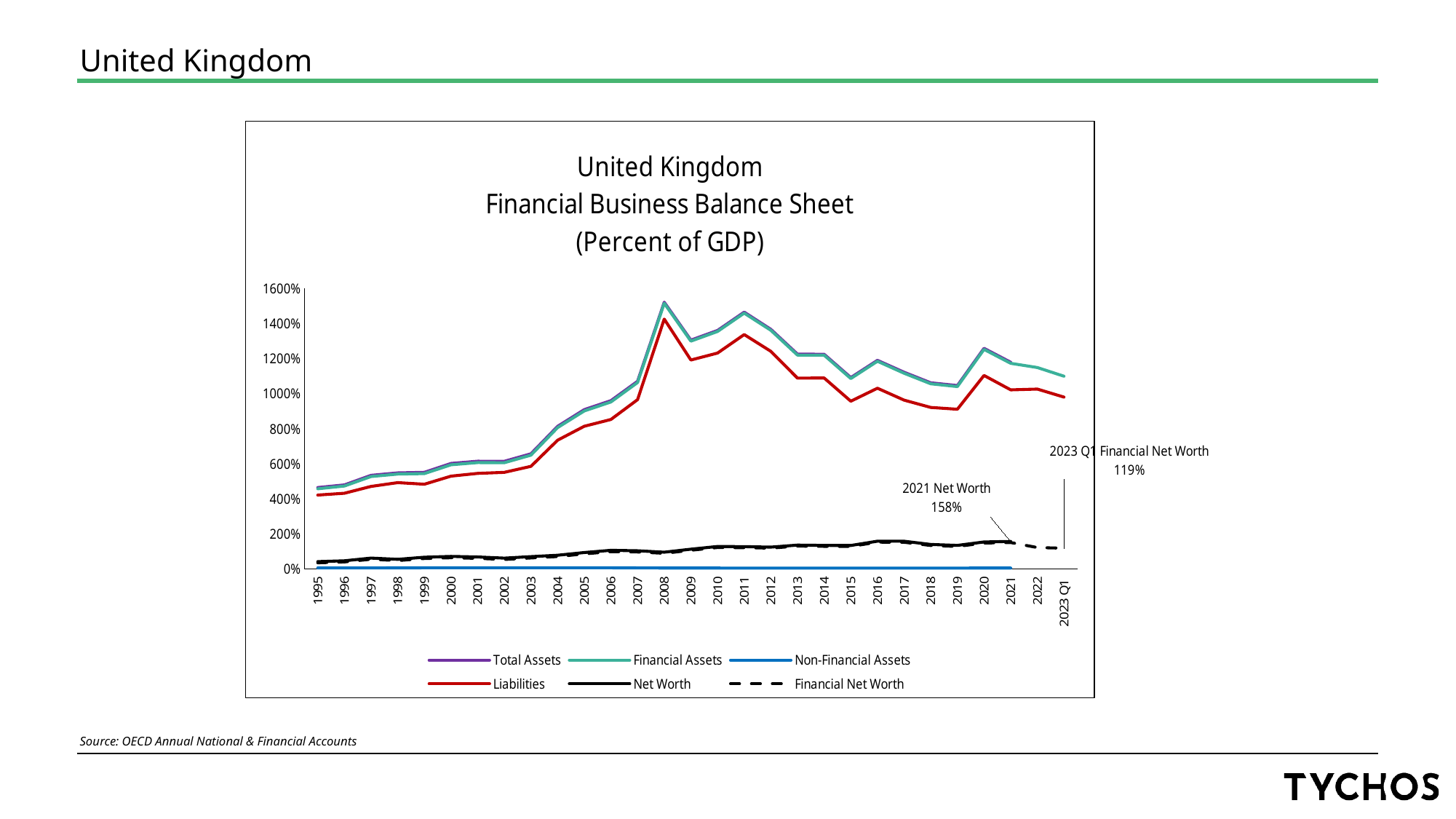
What is the difference between the labelled 2021 Net Worth and the labelled 2023 Q1 Financial Net Worth? 39 percentage points What kind of chart is shown on the slide? Line chart Which is larger: Liabilities in 2008 or Liabilities in 2015? Liabilities in 2008 What is the unit stated in the chart title? Percent of GDP Is the value of Liabilities in 1995 greater or less than 600%? less Which series stays lowest across the whole chart, close to 0%? Non-Financial Assets How many series does the legend list? 6 Is the value of Total Assets in 2008 greater or less than 1400%? greater In which year does the Total Assets line reach its highest point? 2008 What is the 2023 Q1 Financial Net Worth value labelled on the chart? 119% What is the 2021 Net Worth value labelled on the chart? 158% Do Liabilities rise or fall between 1995 and 2008? Rise